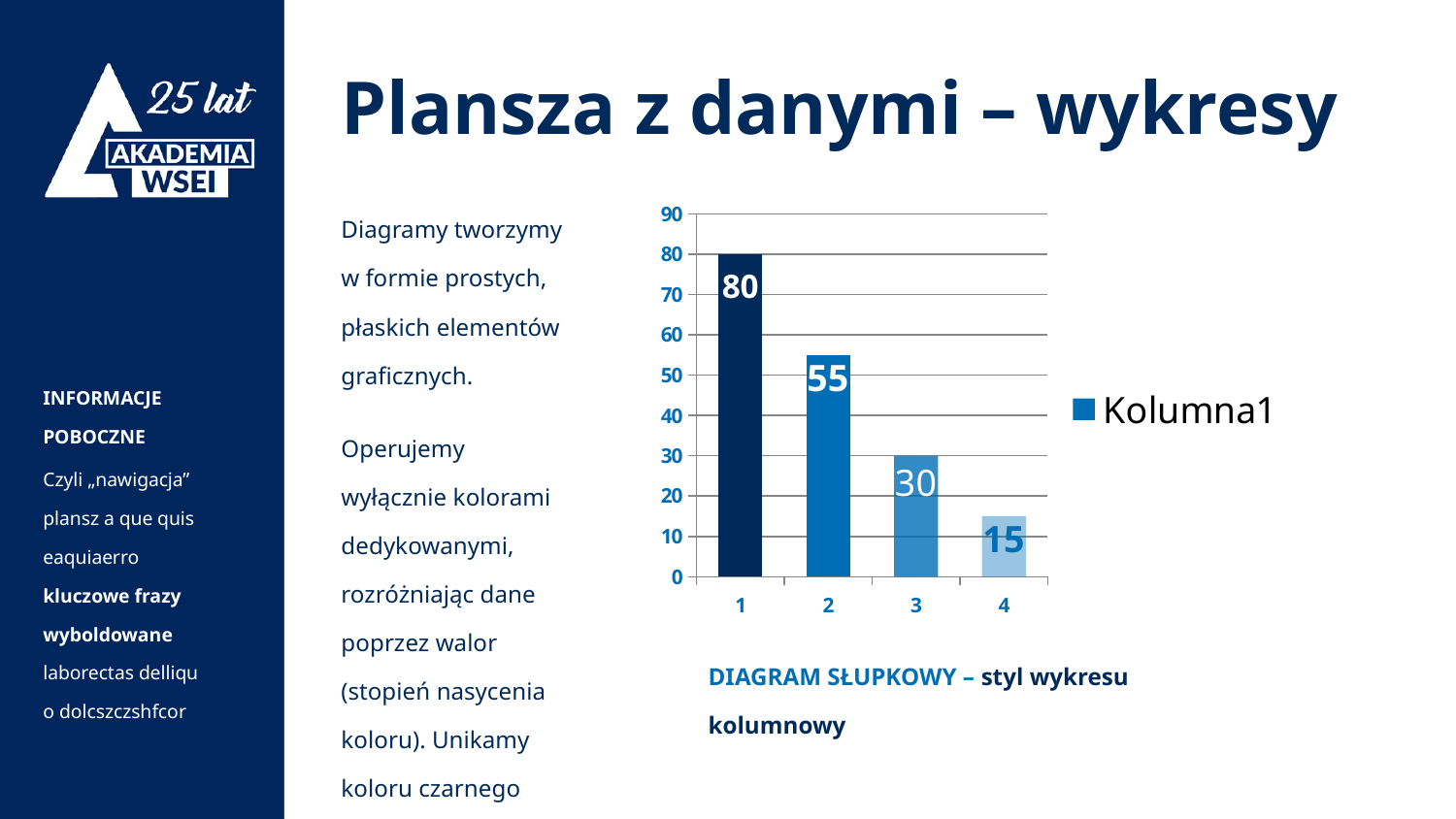
What is the value for category 4? 15 Which category has the lowest value? 4 Do the values rise or fall from category 1 to category 4? fall What is the value for category 1? 80 What kind of chart is shown? bar chart How many series does the legend list? 1 What is the difference between the values for category 3 and category 4? 15 What is the difference between the values for category 1 and category 2? 25 What is the value for category 3? 30 Which category has the highest value? 1 Which is larger, the value for category 2 or the value for category 3? 2 How many categories are shown on the x axis? 4